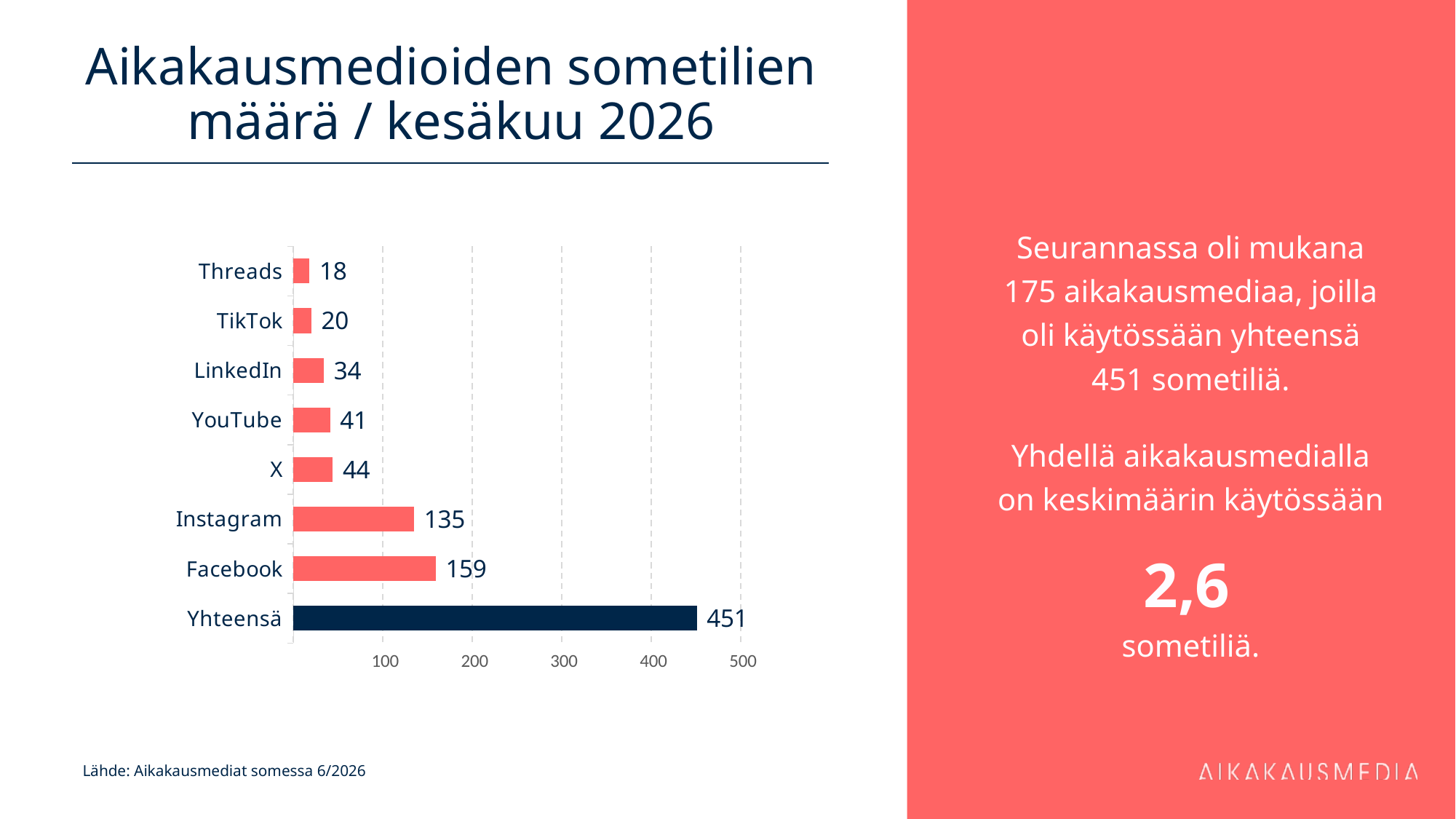
Which individual platform (excluding Yhteensä) has the highest value? Facebook What is the value for the Yhteensä bar? 451 What is the value for Instagram? 135 Is the value for Instagram greater or less than 100? greater What is the title of the slide? Aikakausmedioiden sometilien määrä / kesäkuu 2026 Which category has the lowest value? Threads What is the value for Threads? 18 What is the value for Facebook? 159 Which is larger, the value for X or the value for YouTube? X What kind of chart is shown on the slide? bar chart What is the difference between the values for Facebook and Instagram? 24 How many categories are shown on the chart? 8